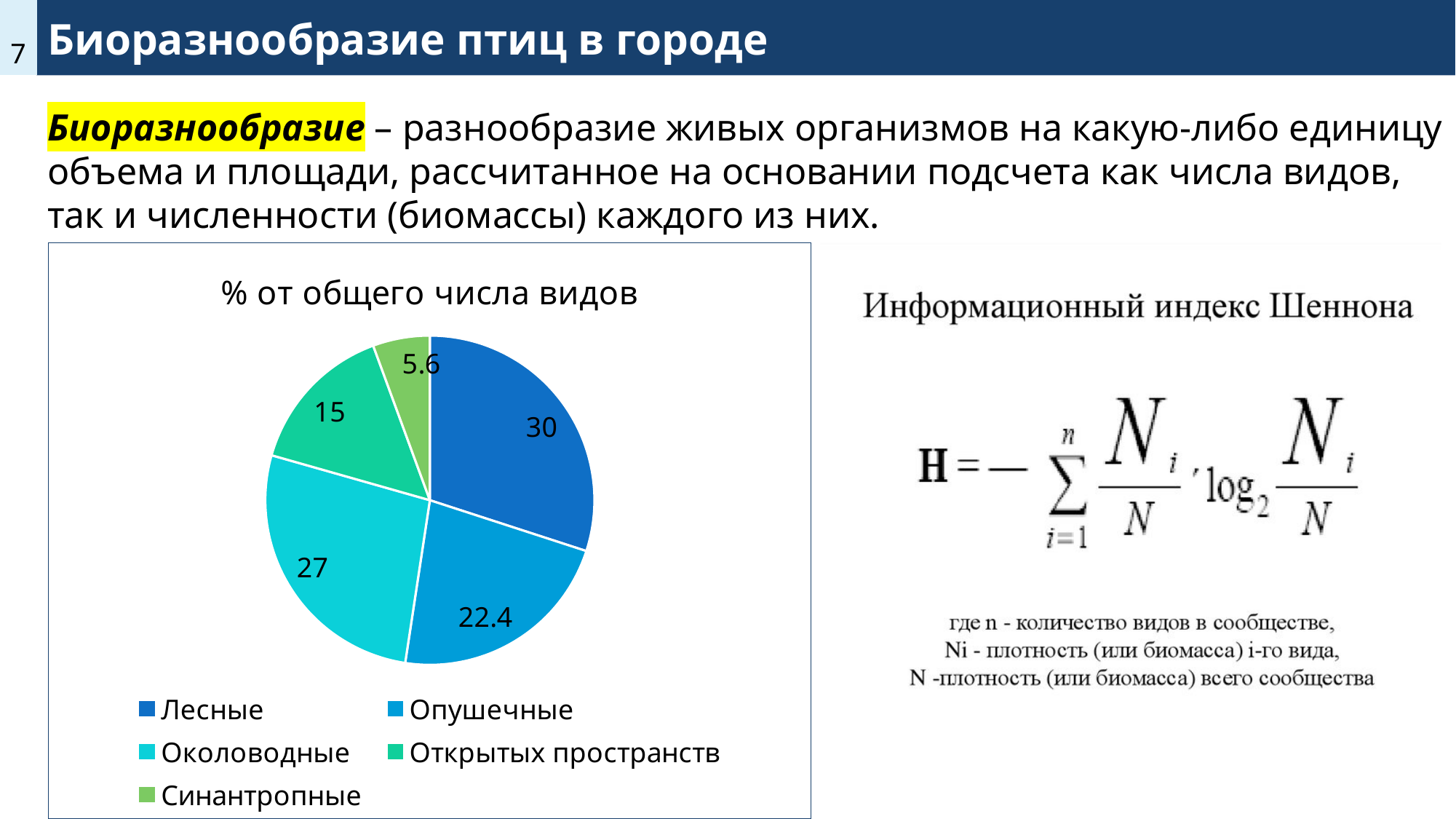
Which is larger, Околоводные or Открытых пространств? Околоводные What is the title of the chart? % от общего числа видов What type of chart is shown on the slide? pie chart What is the value for Опушечные? 22.4 How many slices does the pie chart have? 5 What is the value for Синантропные? 5.6 What is the value for Открытых пространств? 15 Which category has the largest slice? Лесные What is the value for Лесные? 30 What is the value for Околоводные? 27 Which category has the smallest slice? Синантропные What is the difference between the values for Лесные and Опушечные? 7.6